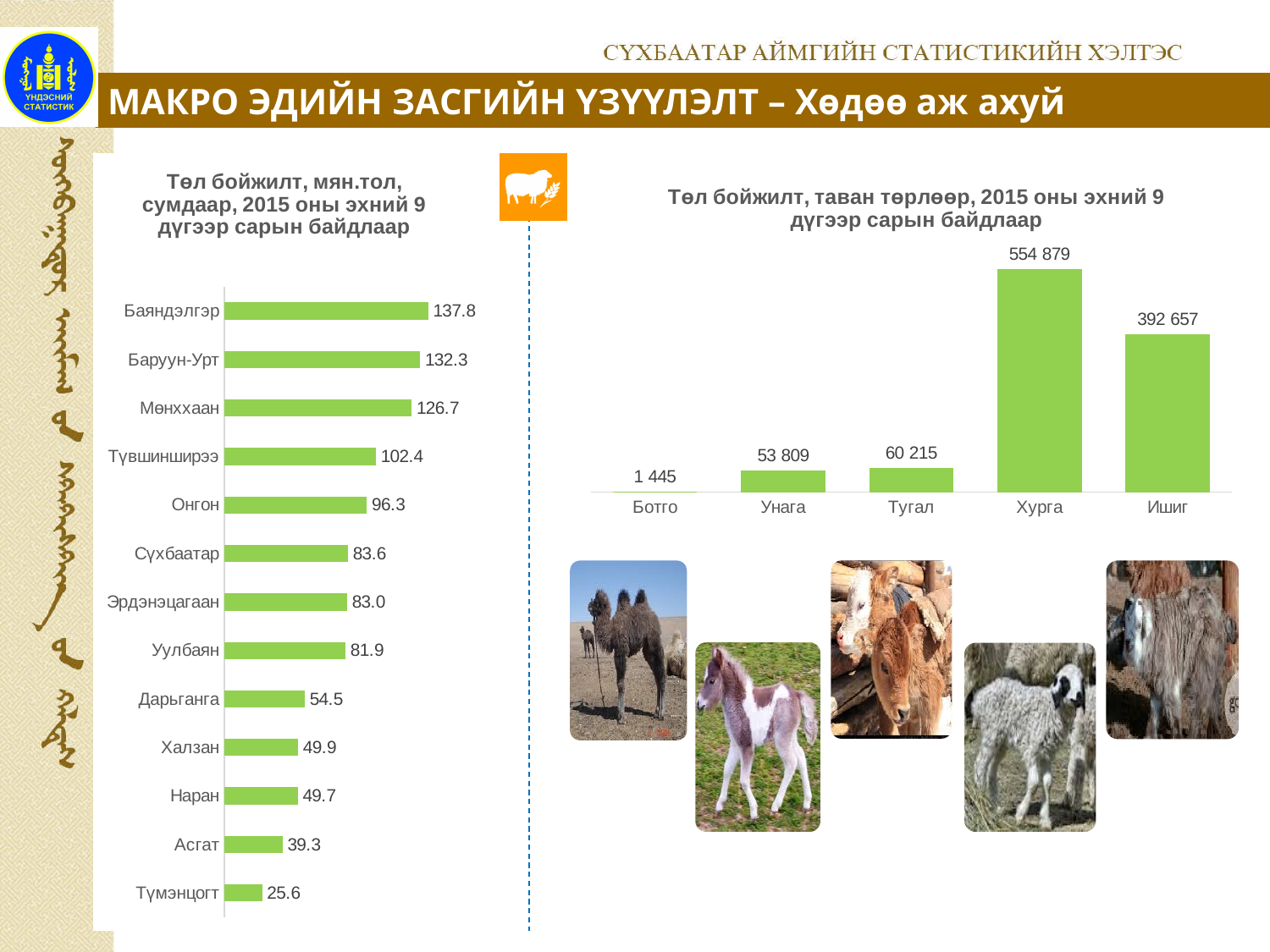
In the right chart (Төл бойжилт, таван төрлөөр), what is the value for Хурга? 554 879 In the right chart (Төл бойжилт, таван төрлөөр), how many categories are shown? 5 In the right chart (Төл бойжилт, таван төрлөөр), which category has the lowest value? Ботго In the right chart (Төл бойжилт, таван төрлөөр), what is the difference between Тугал and Унага? 6 406 In the left chart (Төл бойжилт, мян.тол, сумдаар), what is the value for Мөнххаан? 126.7 In the left chart (Төл бойжилт, мян.тол, сумдаар), which is larger, Дарьганга or Уулбаян? Уулбаян In the left chart (Төл бойжилт, мян.тол, сумдаар), which soum has the lowest value? Түмэнцогт In the left chart (Төл бойжилт, мян.тол, сумдаар), how many soums are shown? 13 In the right chart (Төл бойжилт, таван төрлөөр), what is the value for Ботго? 1 445 In the left chart (Төл бойжилт, мян.тол, сумдаар), which soum has the highest value? Баяндэлгэр In the left chart (Төл бойжилт, мян.тол, сумдаар), what is the difference between Баяндэлгэр and Баруун-Урт? 5.5 What kind of chart is the left chart (Төл бойжилт, мян.тол, сумдаар)? Bar chart